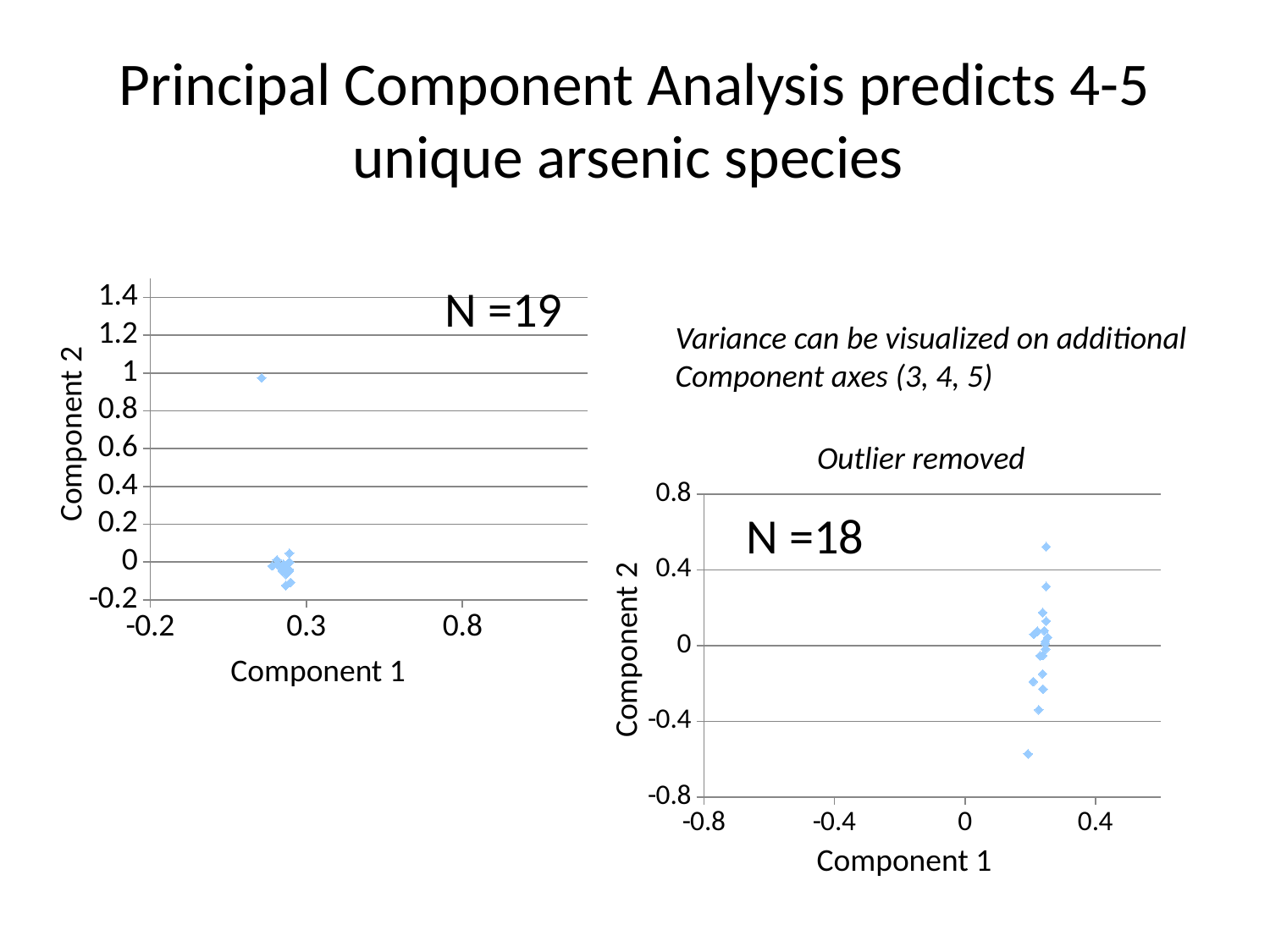
In the left chart, is the Component 1 value of the outlier point greater or less than 0.3? less What is the y-axis label of the left chart? Component 2 In the right chart titled "Outlier removed", how many data points are plotted according to the N label? 18 In the right chart titled "Outlier removed", is the highest Component 2 value greater or less than 0.4? greater In the left chart, is the Component 2 value of the outlier point greater or less than 0.6? greater What kind of chart is the left chart (N = 19)? scatter chart What kind of chart is the right chart titled "Outlier removed"? scatter chart In the left chart, how many data points are plotted according to the N label? 19 What is the title of the right chart? Outlier removed